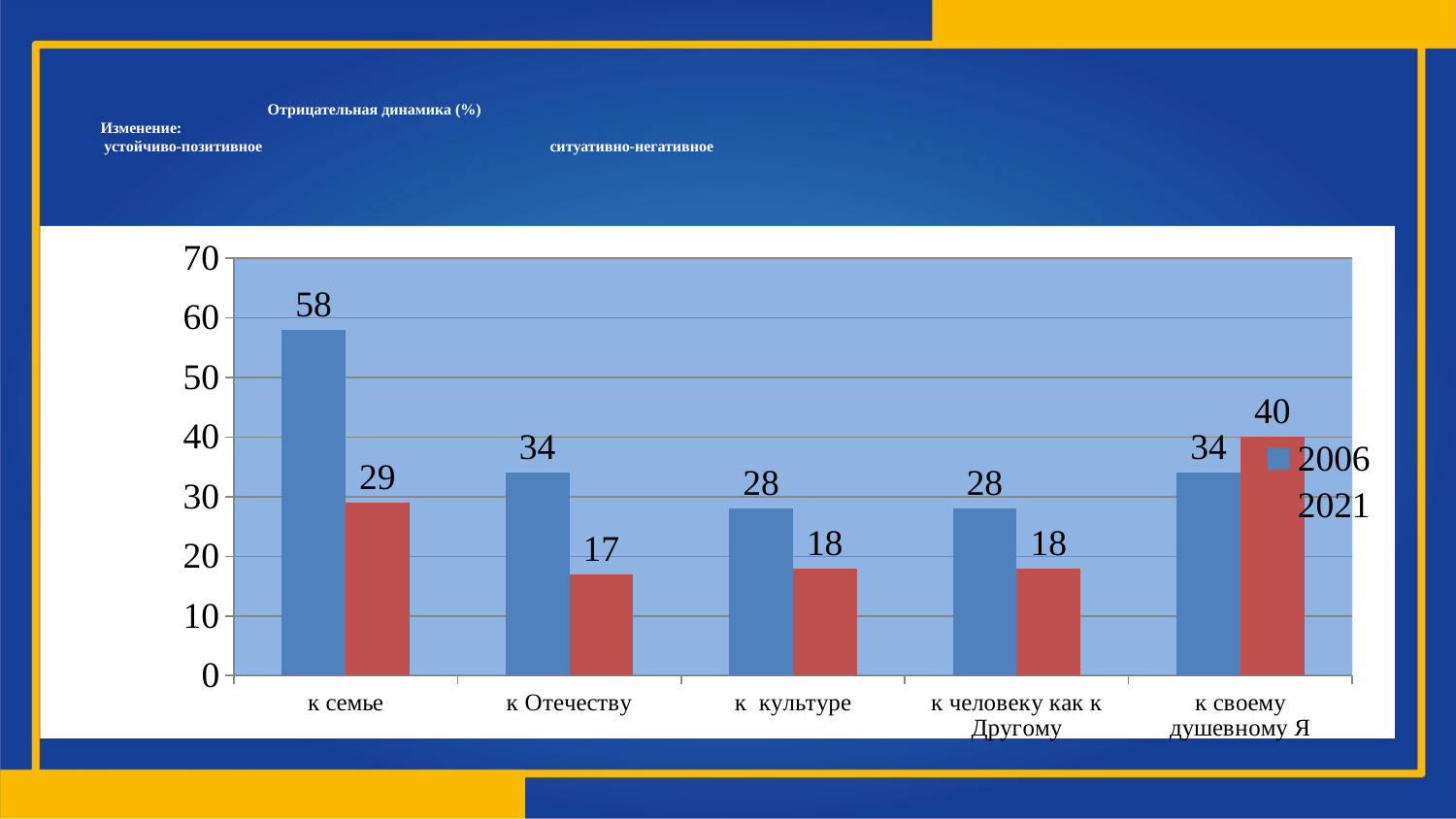
Which is larger for "к своему душевному Я": the 2006 value or the 2021 value? 2021 Which series is shown in red? 2021 How many series does the legend list? 2 Which category has the highest 2006 value? к семье What is the 2006 value for "к семье"? 58 How many categories are shown on the x axis? 5 What is the 2021 value for "к своему душевному Я"? 40 Which category has the lowest 2021 value? к Отечеству Is the 2006 value for "к культуре" greater or less than 20? greater What is the difference between the 2006 and 2021 values for "к семье"? 29 What is the 2021 value for "к Отечеству"? 17 What kind of chart is shown on the slide? bar chart